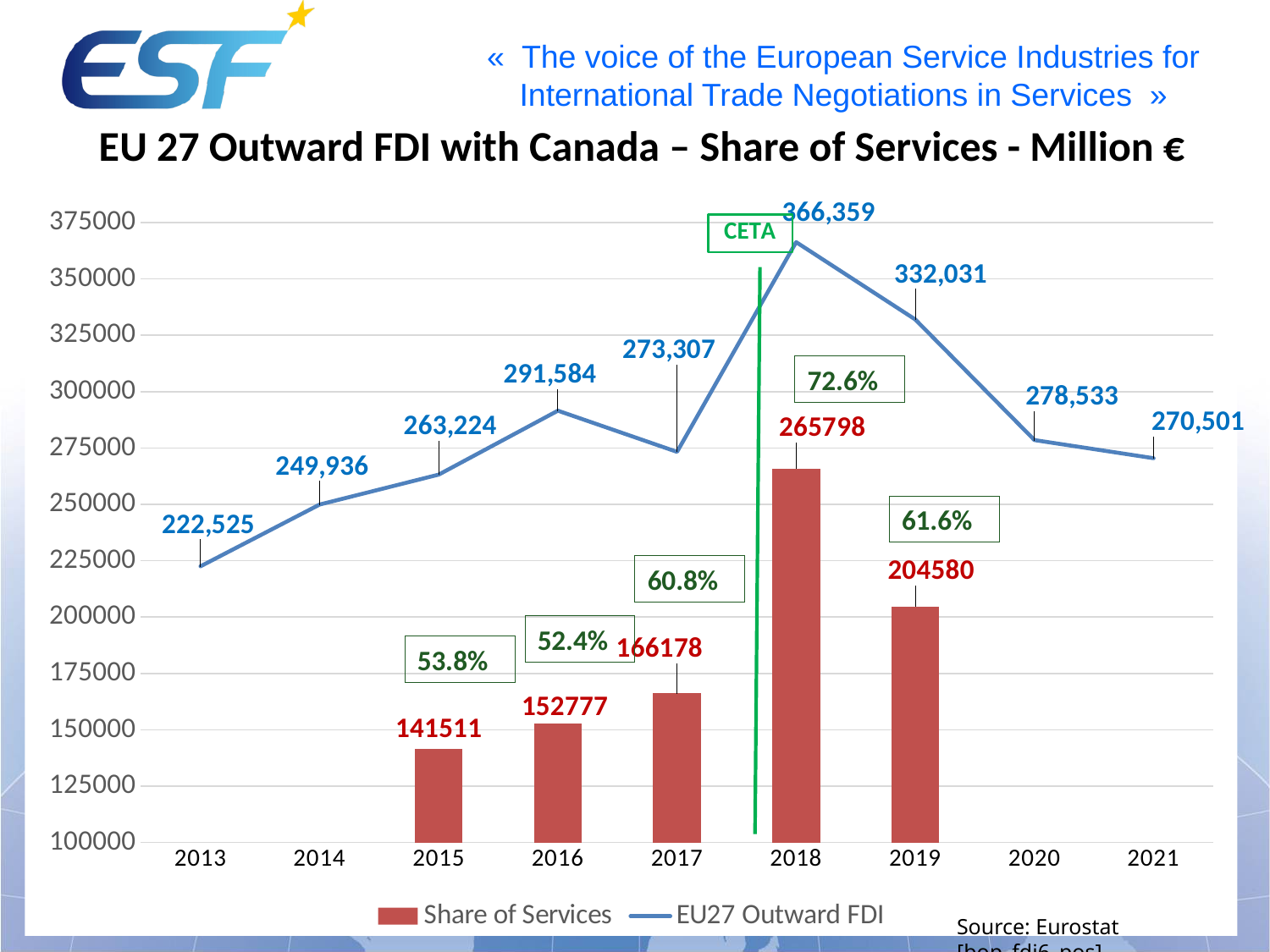
In which year is the Share of Services bar lowest? 2015 What is the difference between the EU27 Outward FDI values for 2018 and 2019? 34,328 How many series does the legend list? 2 What percentage is shown above the Share of Services bar for 2018? 72.6% What is the EU27 Outward FDI value for 2018? 366,359 How many years have a Share of Services bar? 5 What is the Share of Services value for 2016? 152777 What label is shown in the green box next to the vertical green line? CETA Does the EU27 Outward FDI rise or fall from 2018 to 2021? fall In which year is the EU27 Outward FDI highest? 2018 What is the EU27 Outward FDI value for 2013? 222,525 Which is larger, the Share of Services value for 2017 or for 2019? 2019